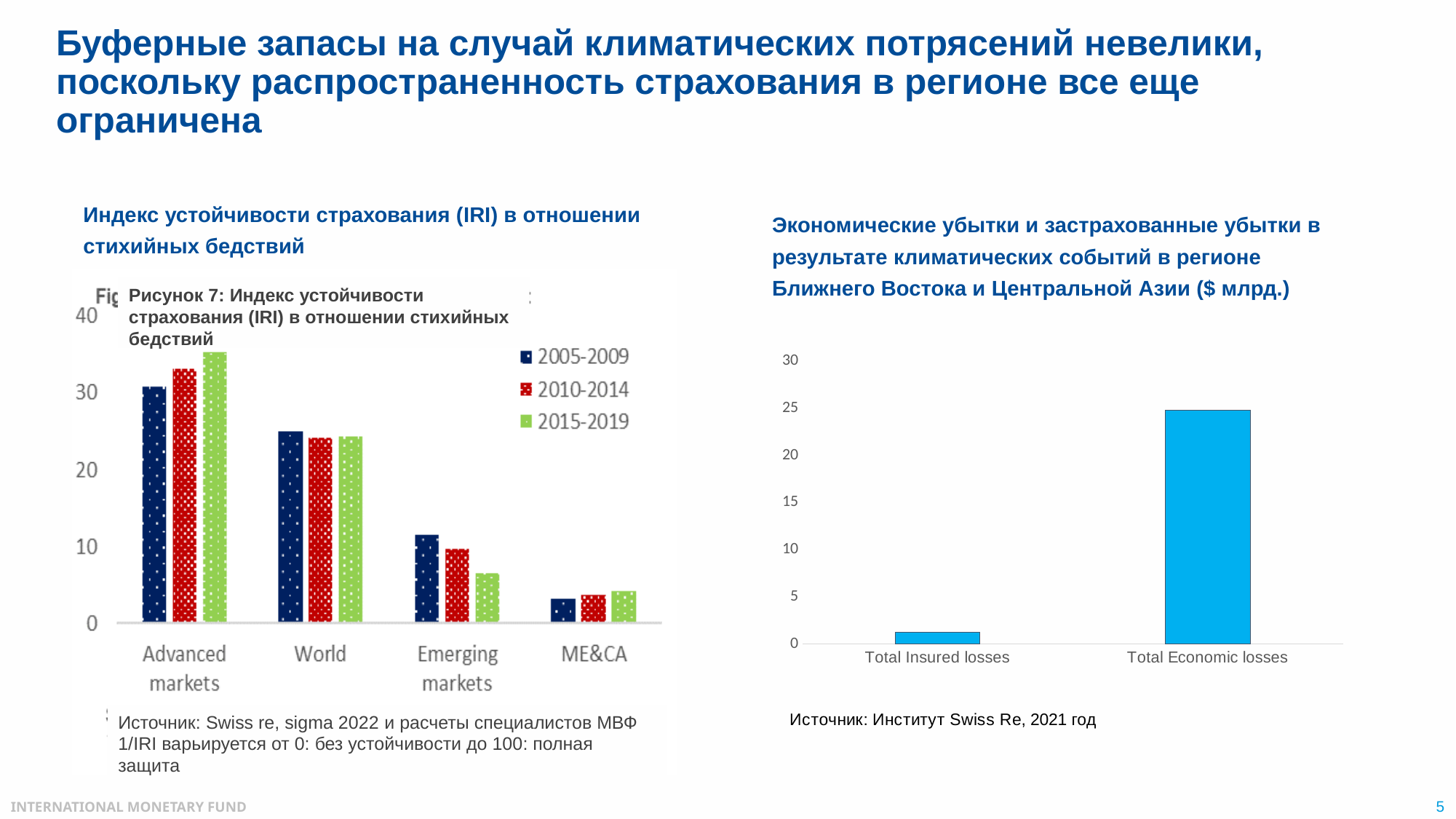
In the chart on the right, which category has the higher value? Total Economic losses In the chart on the right, how many categories are shown on the x axis? 2 In the chart on the right, is the value for Total Insured losses greater or less than 5? less In the chart on the left (Индекс устойчивости страхования), how many categories are shown on the x axis? 4 In the chart on the right, is the value for Total Economic losses greater or less than 20? greater In the chart on the left (Индекс устойчивости страхования), how many series does the legend list? 3 In the chart on the left (Индекс устойчивости страхования), which category has the lowest bars overall? ME&CA In the chart on the left (Индекс устойчивости страхования), which series is shown in green in the legend? 2015-2019 In the chart on the left (Индекс устойчивости страхования), do the values for Emerging markets rise or fall from 2005-2009 to 2015-2019? fall In the chart on the left (Индекс устойчивости страхования), which category has the highest bars overall? Advanced markets What kind of chart is the chart on the right, 'Экономические убытки и застрахованные убытки'? bar chart